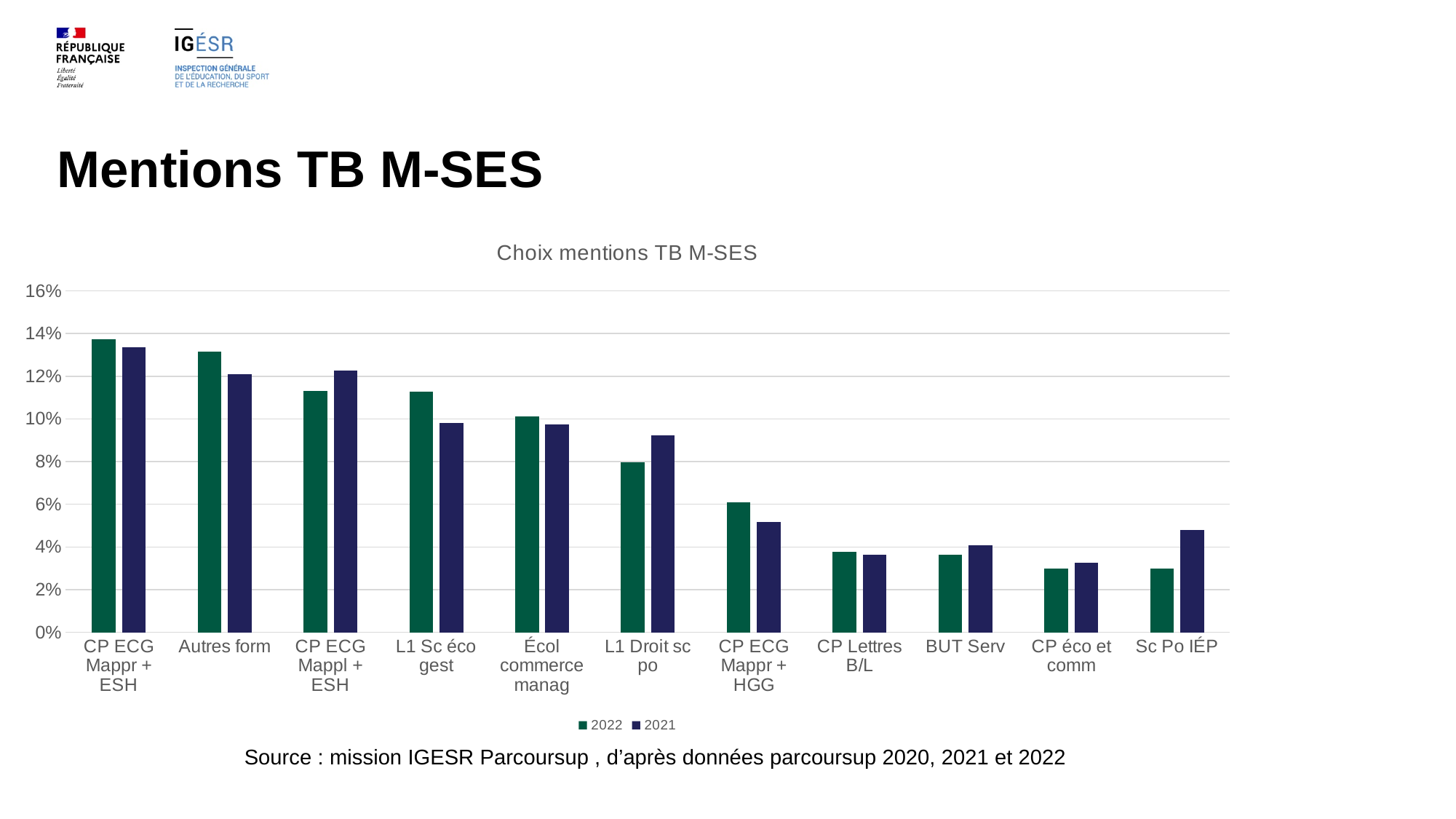
Which category has the highest value for 2021? CP ECG Mappr + ESH Which category has the highest value for 2022? CP ECG Mappr + ESH Is the 2022 value for Autres form greater or less than 12%? greater How many categories are shown on the x axis of the chart? 11 For L1 Sc éco gest, which year has the larger value, 2022 or 2021? 2022 For Sc Po IÉP, which year has the larger value, 2022 or 2021? 2021 Is the 2022 value for BUT Serv greater or less than 4%? less What kind of chart is shown on the slide? bar chart Do the 2022 values generally rise or fall from left to right along the x axis? fall How many series does the legend list? 2 What is the title of the chart? Choix mentions TB M-SES Is the 2021 value for Sc Po IÉP greater or less than 4%? greater